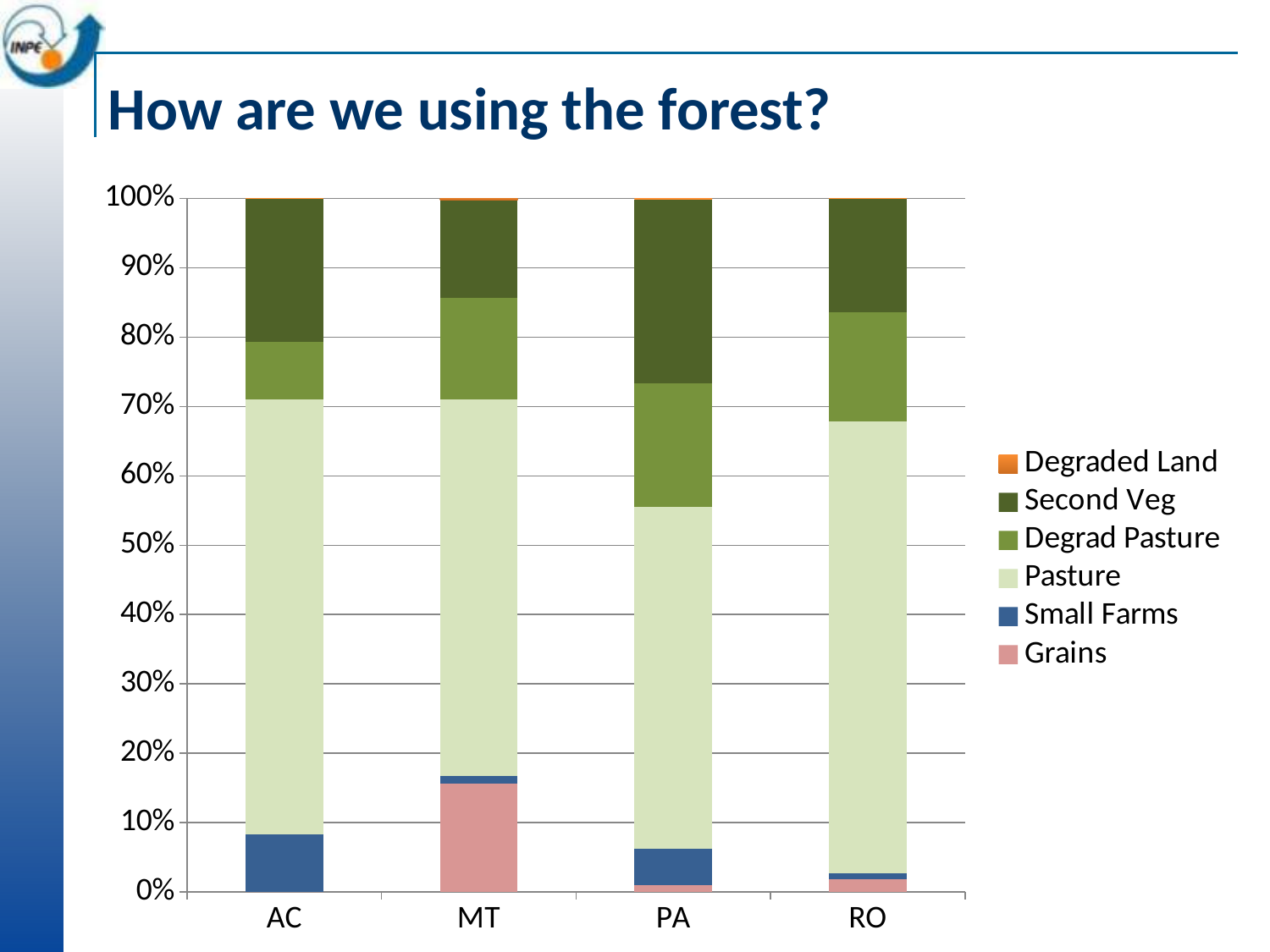
Which state has the smallest Degrad Pasture share? AC What kind of chart is shown on the slide? stacked bar chart Is the Small Farms share for AC greater or less than 10%? less Which state has the largest Grains share? MT Which series is listed first (at the top) in the legend? Degraded Land Is the Grains share for MT greater or less than 10%? greater Which is larger, the Second Veg share for PA or for MT? PA What is the title of the slide containing the chart? How are we using the forest? Which state has the largest Second Veg share? PA How many series does the legend list? 6 Which state has the largest Small Farms share? AC How many states (categories) are shown on the x axis? 4